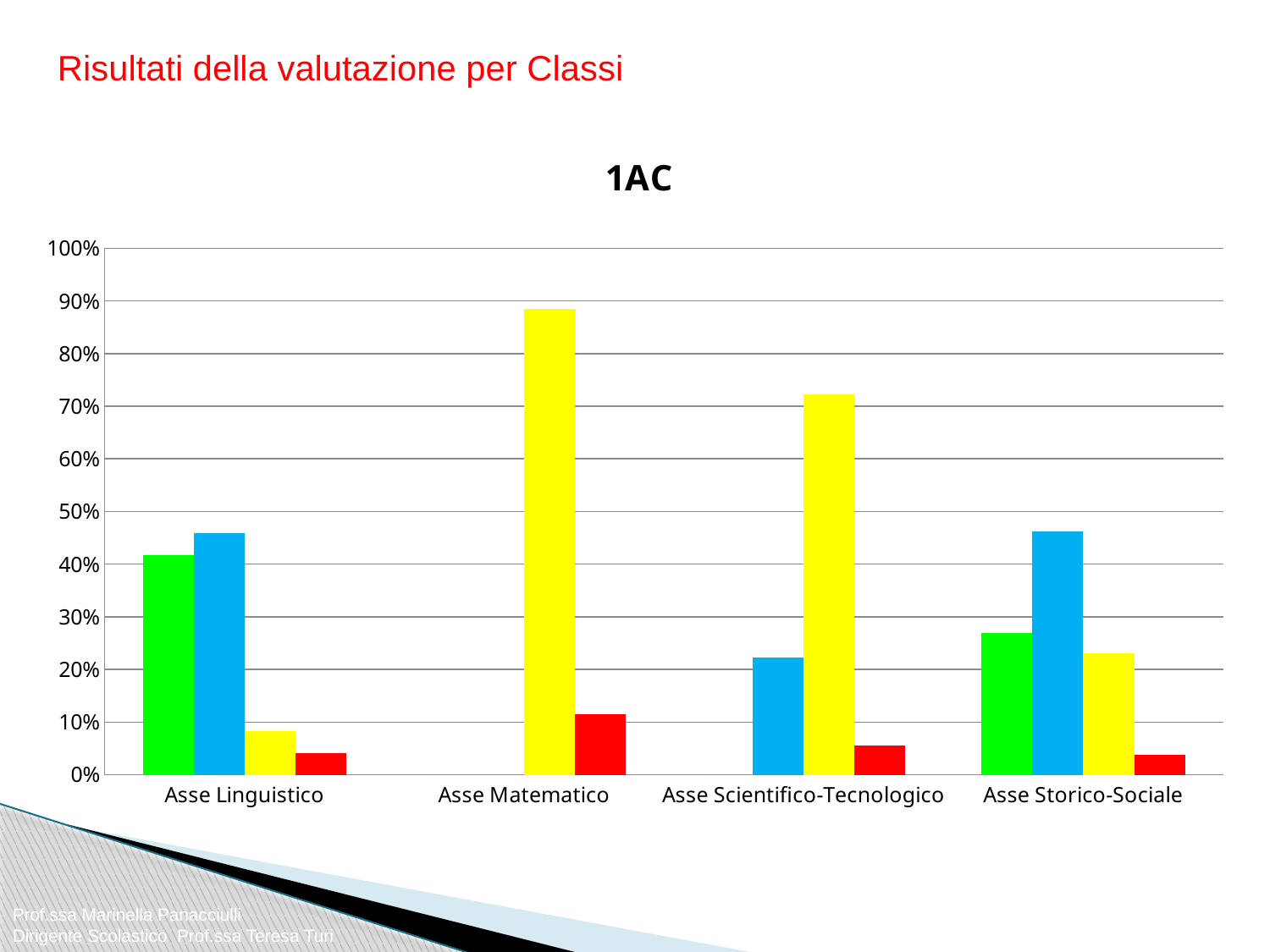
Is the yellow bar for Asse Matematico greater or less than 80%? greater Is the blue bar for Asse Linguistico greater or less than 40%? greater What kind of chart is shown on the slide? bar chart Which category has the tallest bar in the chart? Asse Matematico How many categories are shown on the x axis of the chart? 4 What is the title of the chart? 1AC Which category has the tallest yellow bar? Asse Matematico Which is larger: the green bar for Asse Linguistico or the green bar for Asse Storico-Sociale? Asse Linguistico Is the yellow bar for Asse Scientifico-Tecnologico greater or less than 60%? greater Which is larger: the yellow bar for Asse Matematico or the yellow bar for Asse Scientifico-Tecnologico? Asse Matematico